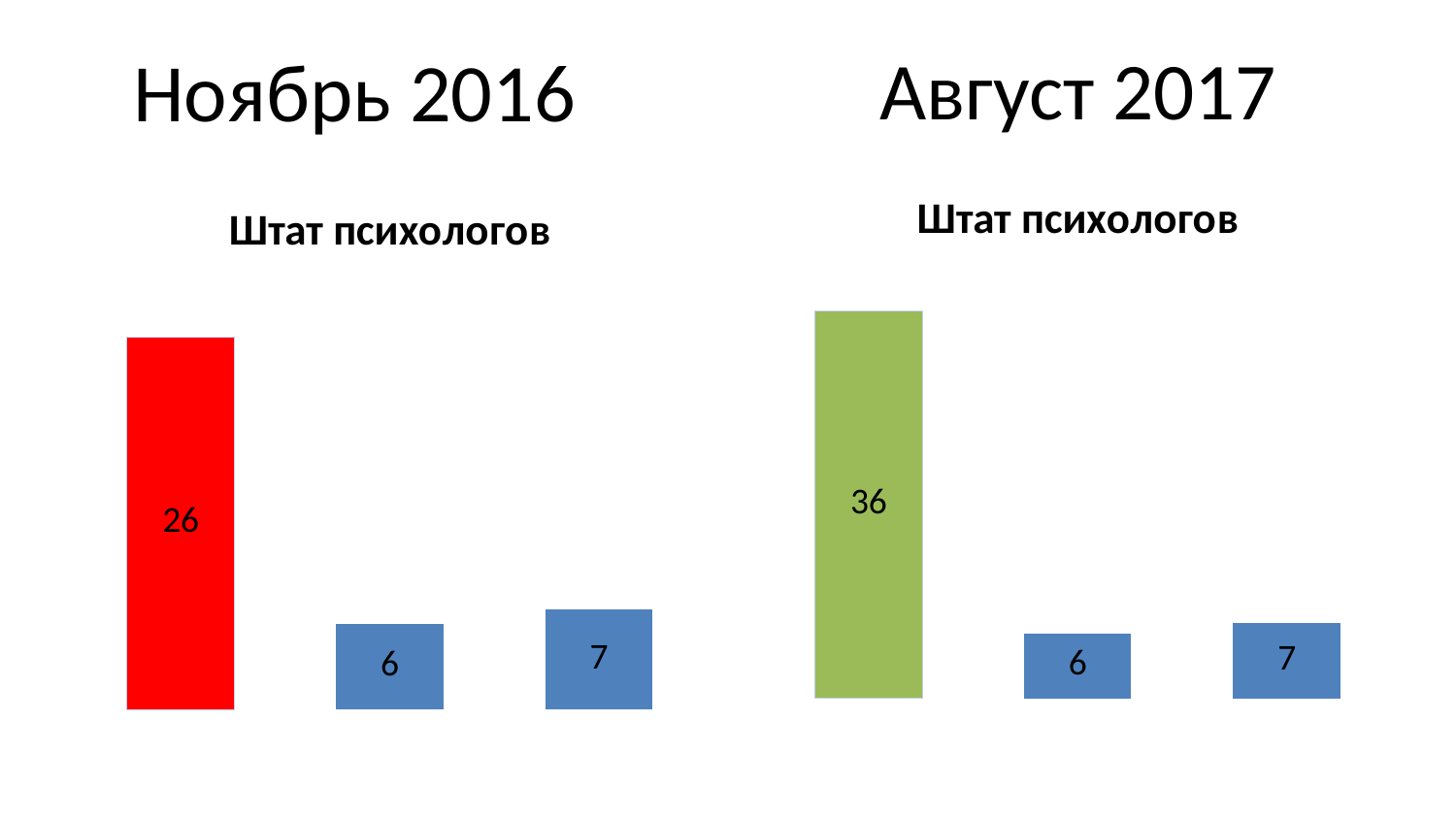
How many bars does the left chart under 'Ноябрь 2016' have? 3 What is the difference between the tallest bar in the right chart (Август 2017) and the tallest bar in the left chart (Ноябрь 2016)? 10 What type of chart is shown under 'Август 2017'? Bar chart In the left chart under 'Ноябрь 2016', what is the difference between the red bar and the rightmost bar? 19 What is the title of the chart under 'Ноябрь 2016'? Штат психологов Which is larger: the tallest bar in the left chart (Ноябрь 2016) or the tallest bar in the right chart (Август 2017)? Август 2017 In the right chart under 'Август 2017', what value is shown on the rightmost bar? 7 In the left chart under 'Ноябрь 2016', what is the highest value shown? 26 In the left chart under 'Ноябрь 2016', what value is shown on the red bar? 26 In the left chart under 'Ноябрь 2016', what value is shown on the middle bar? 6 In the right chart under 'Август 2017', what is the lowest value shown? 6 In the right chart under 'Август 2017', what value is shown on the green bar? 36